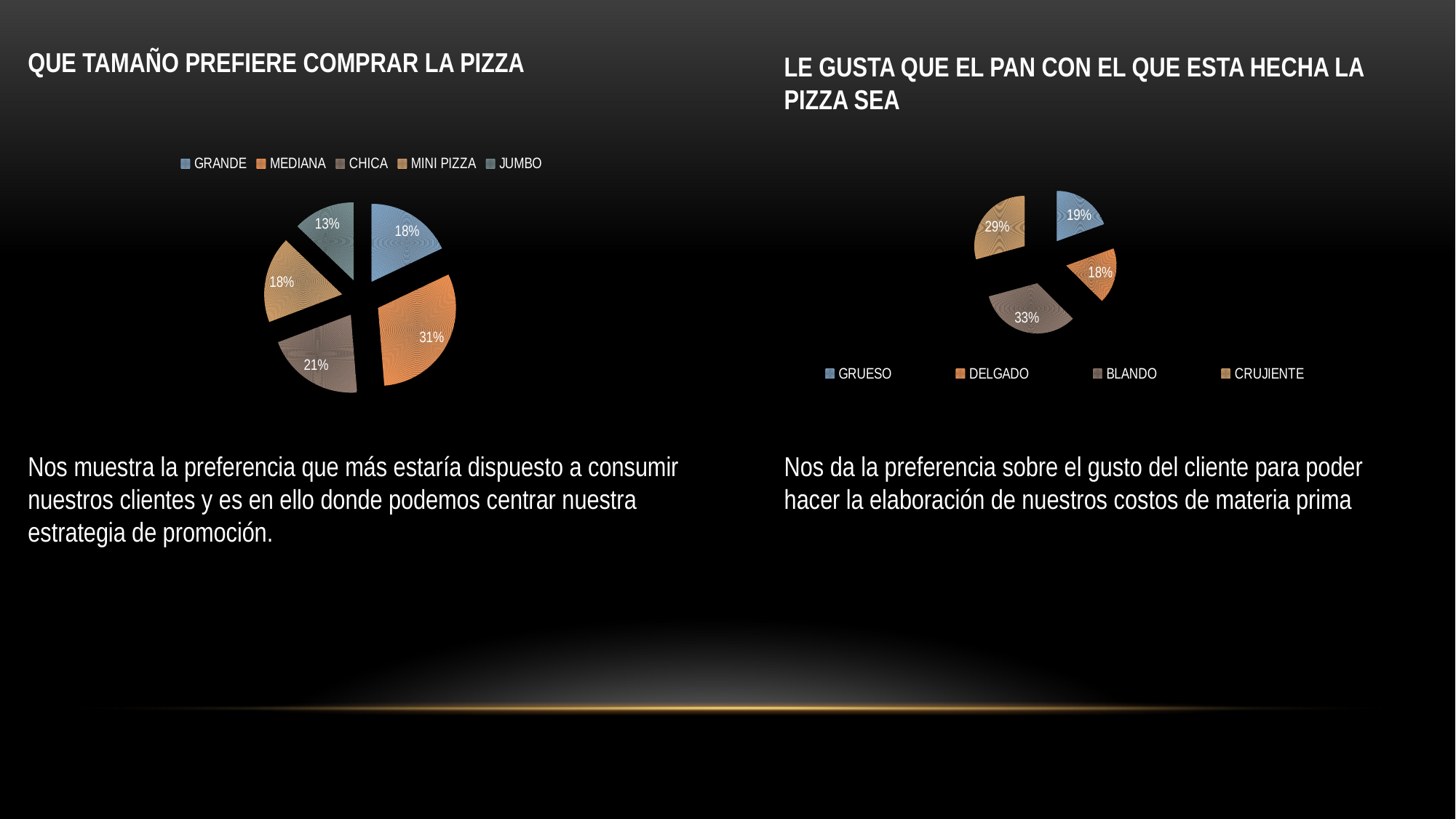
In the chart titled 'LE GUSTA QUE EL PAN CON EL QUE ESTA HECHA LA PIZZA SEA', how many categories does the legend list? 4 In the chart titled 'LE GUSTA QUE EL PAN CON EL QUE ESTA HECHA LA PIZZA SEA', which category has the largest slice? BLANDO In the chart titled 'QUE TAMAÑO PREFIERE COMPRAR LA PIZZA', what share does JUMBO have? 13% In the chart titled 'QUE TAMAÑO PREFIERE COMPRAR LA PIZZA', how many categories does the legend list? 5 In the chart titled 'QUE TAMAÑO PREFIERE COMPRAR LA PIZZA', which category has the smallest slice? JUMBO In the chart titled 'QUE TAMAÑO PREFIERE COMPRAR LA PIZZA', which category has the largest slice? MEDIANA In the chart titled 'LE GUSTA QUE EL PAN CON EL QUE ESTA HECHA LA PIZZA SEA', what share does CRUJIENTE have? 29% In the chart titled 'LE GUSTA QUE EL PAN CON EL QUE ESTA HECHA LA PIZZA SEA', which is larger, GRUESO or CRUJIENTE? CRUJIENTE In the chart titled 'QUE TAMAÑO PREFIERE COMPRAR LA PIZZA', what share does MEDIANA have? 31% In the chart titled 'LE GUSTA QUE EL PAN CON EL QUE ESTA HECHA LA PIZZA SEA', what share does BLANDO have? 33% In the chart titled 'QUE TAMAÑO PREFIERE COMPRAR LA PIZZA', what is the difference between the MEDIANA and CHICA shares? 10% What kind of chart is used in the chart titled 'QUE TAMAÑO PREFIERE COMPRAR LA PIZZA'? Pie chart